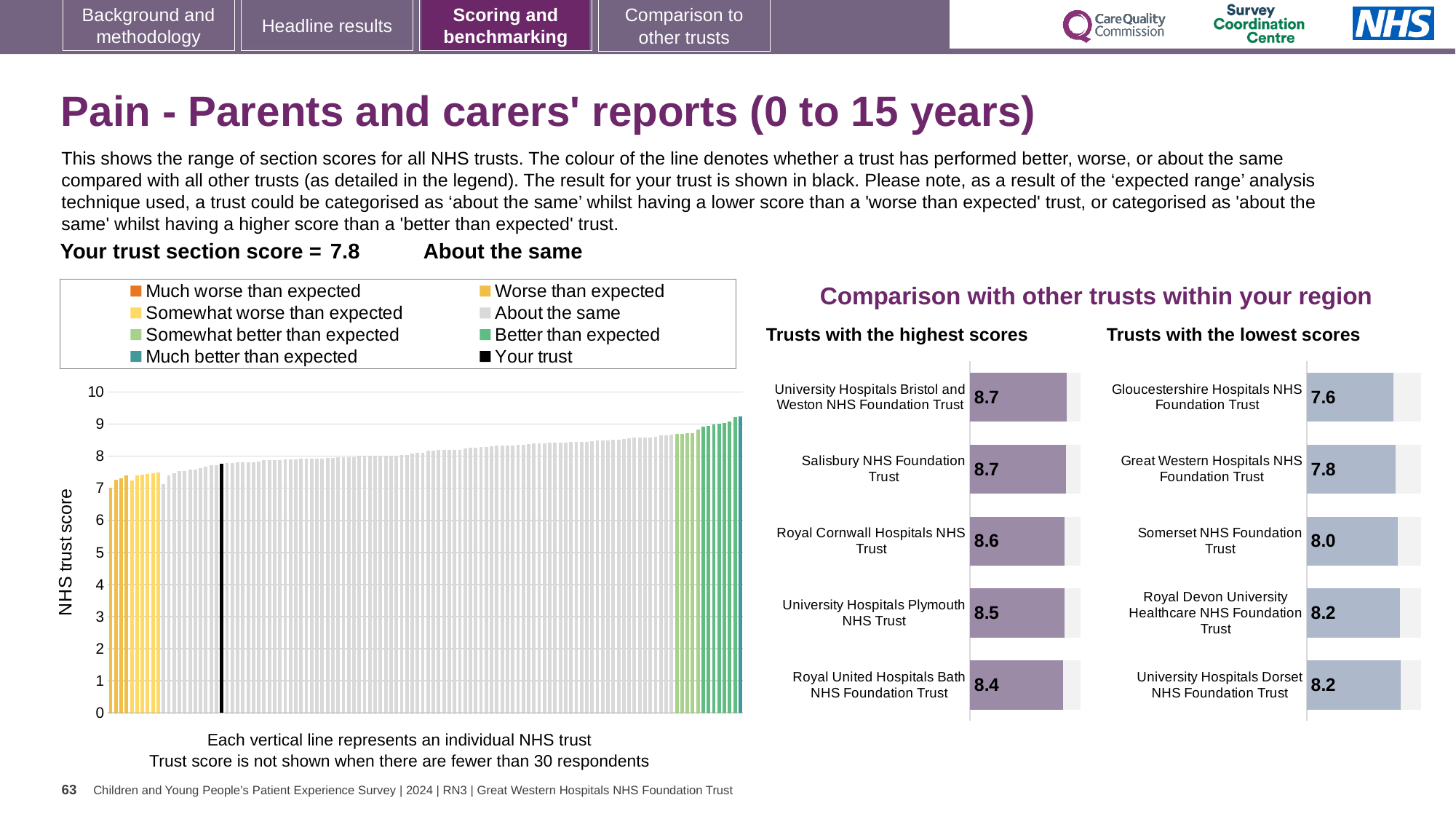
In the 'Trusts with the lowest scores' chart, which has the larger score: Great Western Hospitals NHS Foundation Trust or Somerset NHS Foundation Trust? Somerset NHS Foundation Trust How many entries does the legend of the large chart on the left list? 8 In the 'Trusts with the lowest scores' chart, what is the score for Somerset NHS Foundation Trust? 8.0 In the 'Trusts with the highest scores' chart, what is the score for Royal Cornwall Hospitals NHS Trust? 8.6 In the large chart on the left, do the trust scores rise or fall from left to right along the x axis? Rise What kind of chart is the large chart on the left showing NHS trust scores? Bar chart In the 'Trusts with the highest scores' chart, what is the score for Royal United Hospitals Bath NHS Foundation Trust? 8.4 In the 'Trusts with the highest scores' chart, what is the difference between the score for University Hospitals Bristol and Weston NHS Foundation Trust and the score for Royal United Hospitals Bath NHS Foundation Trust? 0.3 In the 'Trusts with the highest scores' chart, which trust has the lowest score? Royal United Hospitals Bath NHS Foundation Trust In the 'Trusts with the lowest scores' chart, what is the score for Gloucestershire Hospitals NHS Foundation Trust? 7.6 How many trusts are listed in the 'Trusts with the lowest scores' chart? 5 In the 'Trusts with the lowest scores' chart, which trust has the lowest score? Gloucestershire Hospitals NHS Foundation Trust